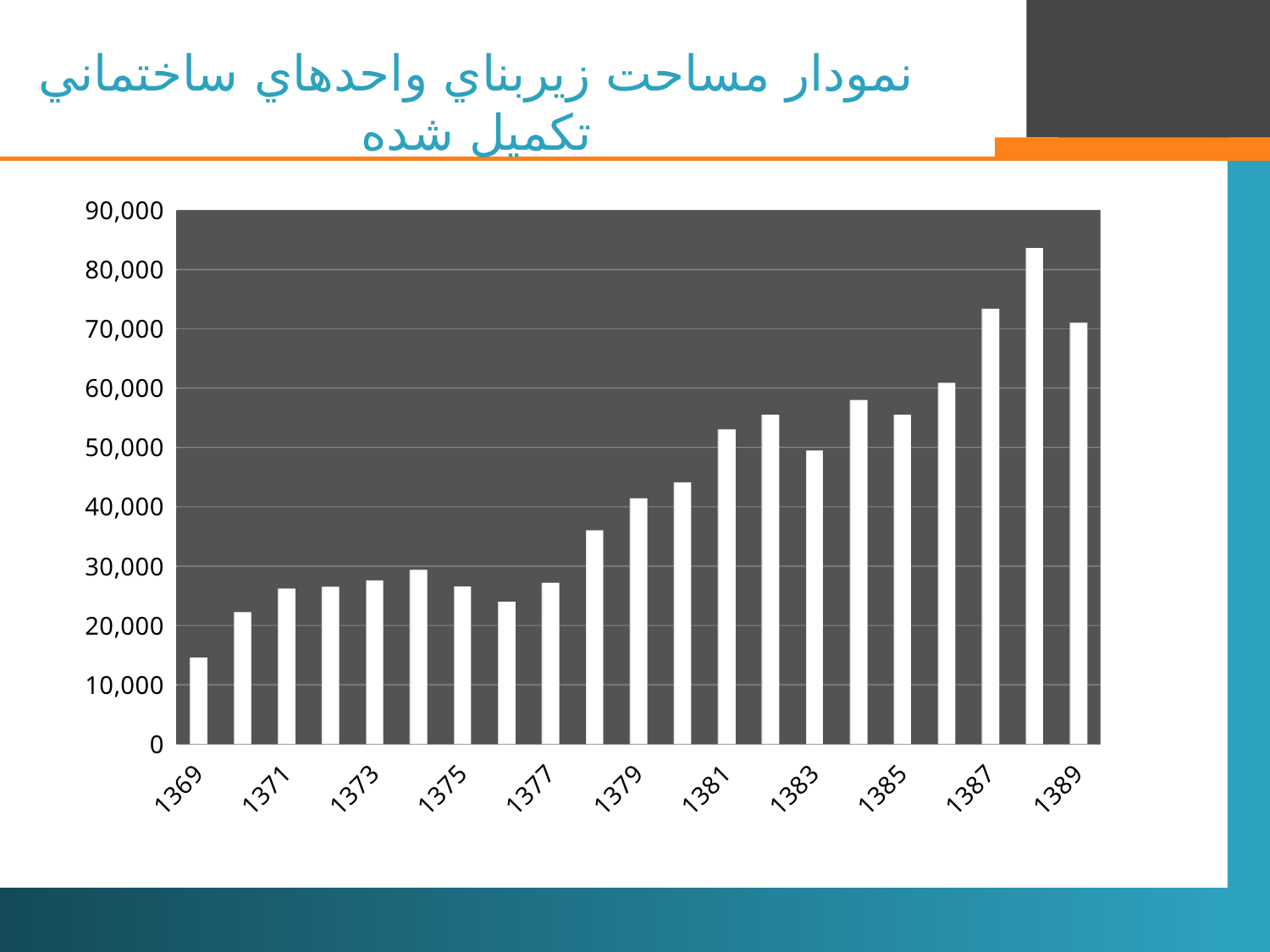
Is the value for 1377 greater or less than 30,000? less What kind of chart is shown on the slide? bar chart Which has the larger value, 1387 or 1389? 1387 Is the value for 1381 greater or less than 50,000? greater Do the values generally rise or fall from 1369 to 1389? rise Is the value for 1387 greater or less than 70,000? greater Which labeled year has the lowest bar in the chart? 1369 What colour are the bars in the chart? white How many bars are plotted in the chart? 21 Which has the larger value, 1375 or 1381? 1381